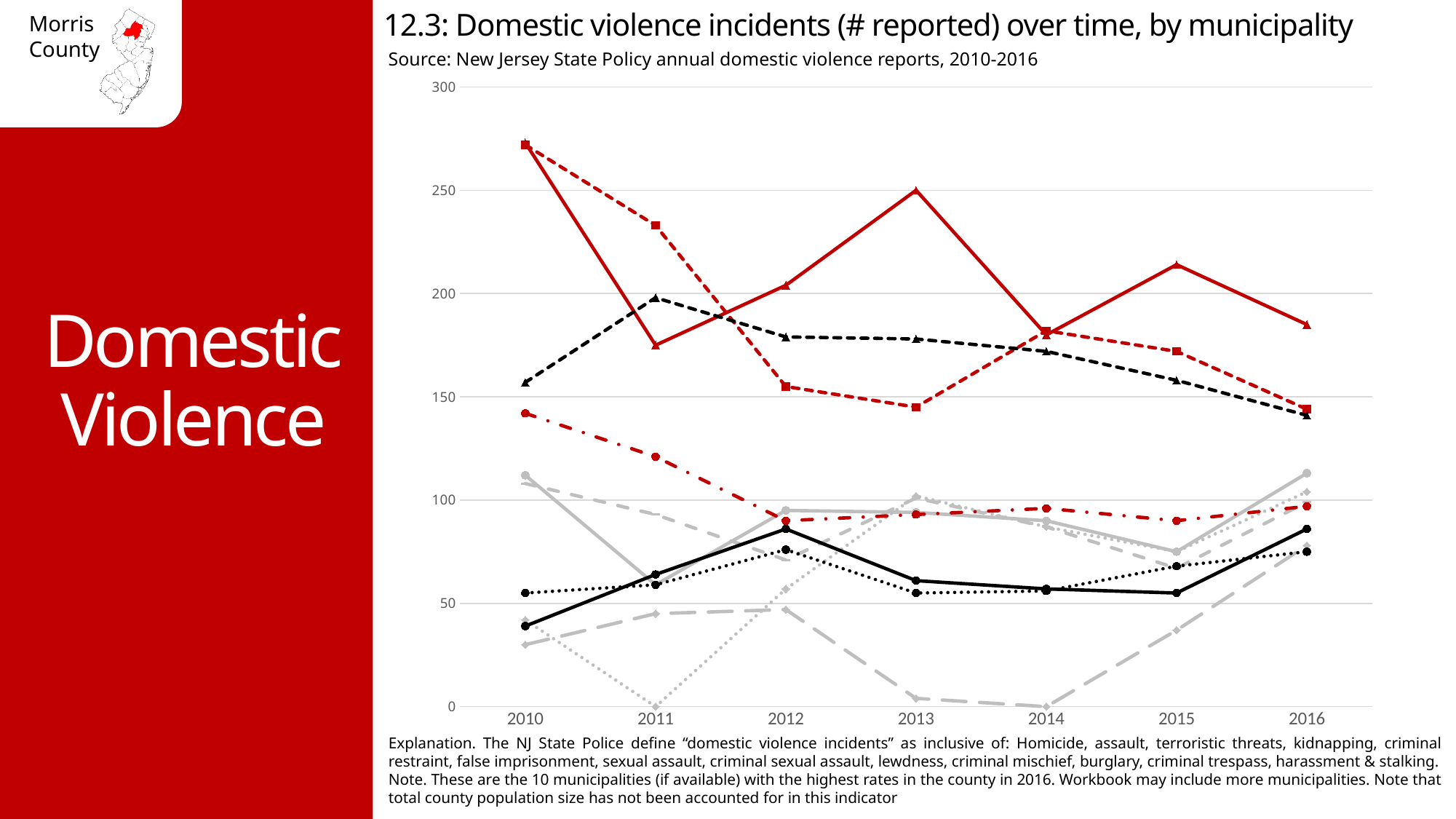
Is the value of the solid black line in 2010 greater or less than 50? less Is the value of the solid red line in 2010 greater or less than 250? greater What is the title of the chart? 12.3: Domestic violence incidents (# reported) over time, by municipality In which year does the solid red line reach its highest value? 2010 In 2016, which is higher: the solid red line or the black dashed line with triangle markers? the solid red line What source is cited for the chart data? New Jersey State Policy annual domestic violence reports, 2010-2016 What kind of chart is shown on the slide? line chart How many years are plotted along the x axis of the chart? 7 Does the red dash-dot line rise or fall from 2010 to 2012? fall Does the black dashed line with triangle markers rise or fall from 2012 to 2016? fall Is the value of the solid red line in 2013 greater or less than 200? greater